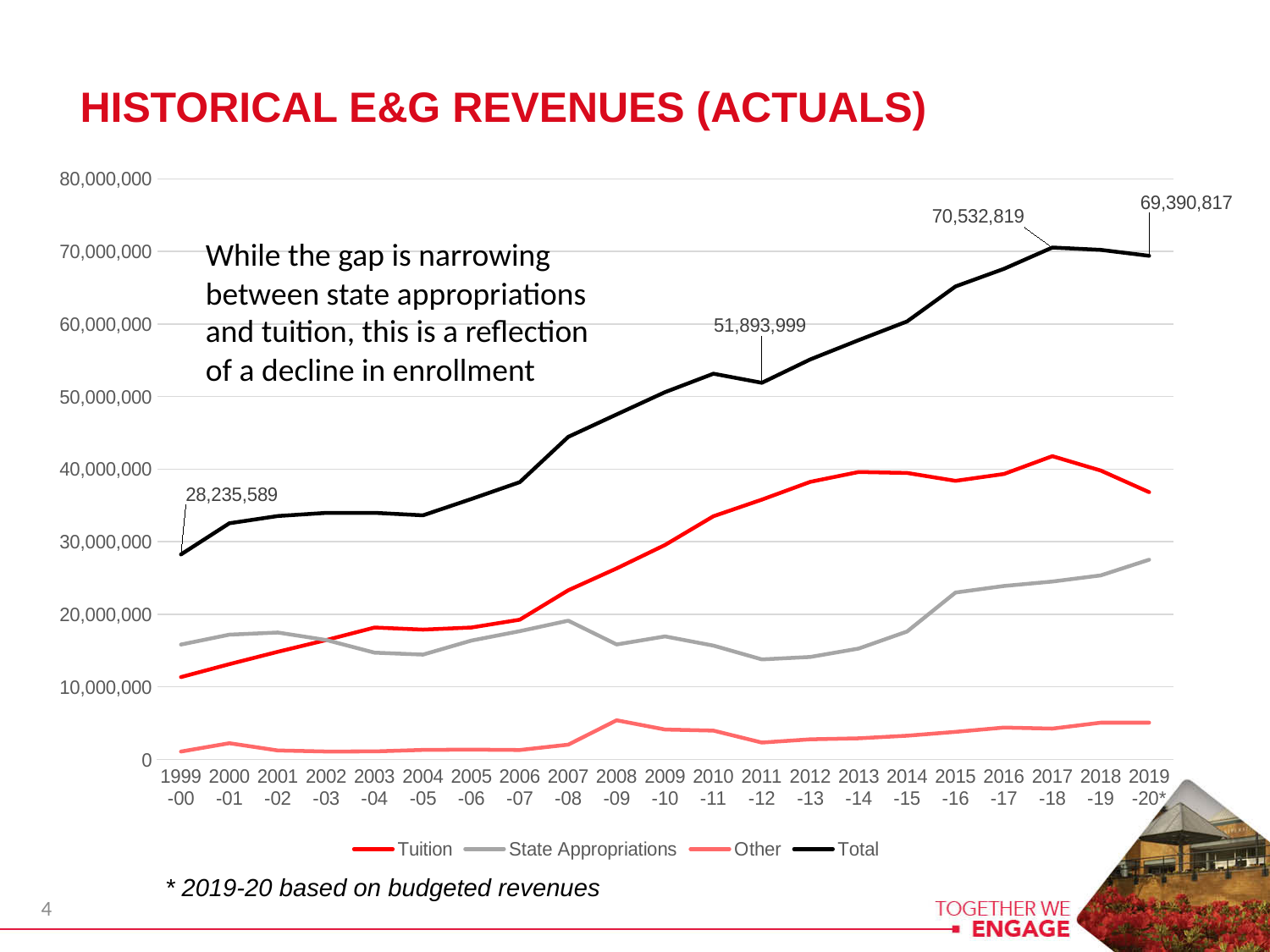
What kind of chart is shown on the slide? line chart Which is larger, the Total for 2017-18 or the Total for 2019-20*? 2017-18 What is the difference between the Total for 2017-18 and the Total for 2019-20*? 1,142,002 How many series does the legend list? 4 Is the Tuition value for 2019-20* greater or less than 40,000,000? less What is the Total value for 1999-00? 28,235,589 How many fiscal years are plotted on the x axis? 21 What is the Total value for 2019-20*? 69,390,817 Does the Total series generally rise or fall from 1999-00 to 2019-20*? rise Is the State Appropriations value for 2019-20* greater or less than 20,000,000? greater What is the Total value for 2017-18? 70,532,819 What is the Total value for 2011-12? 51,893,999